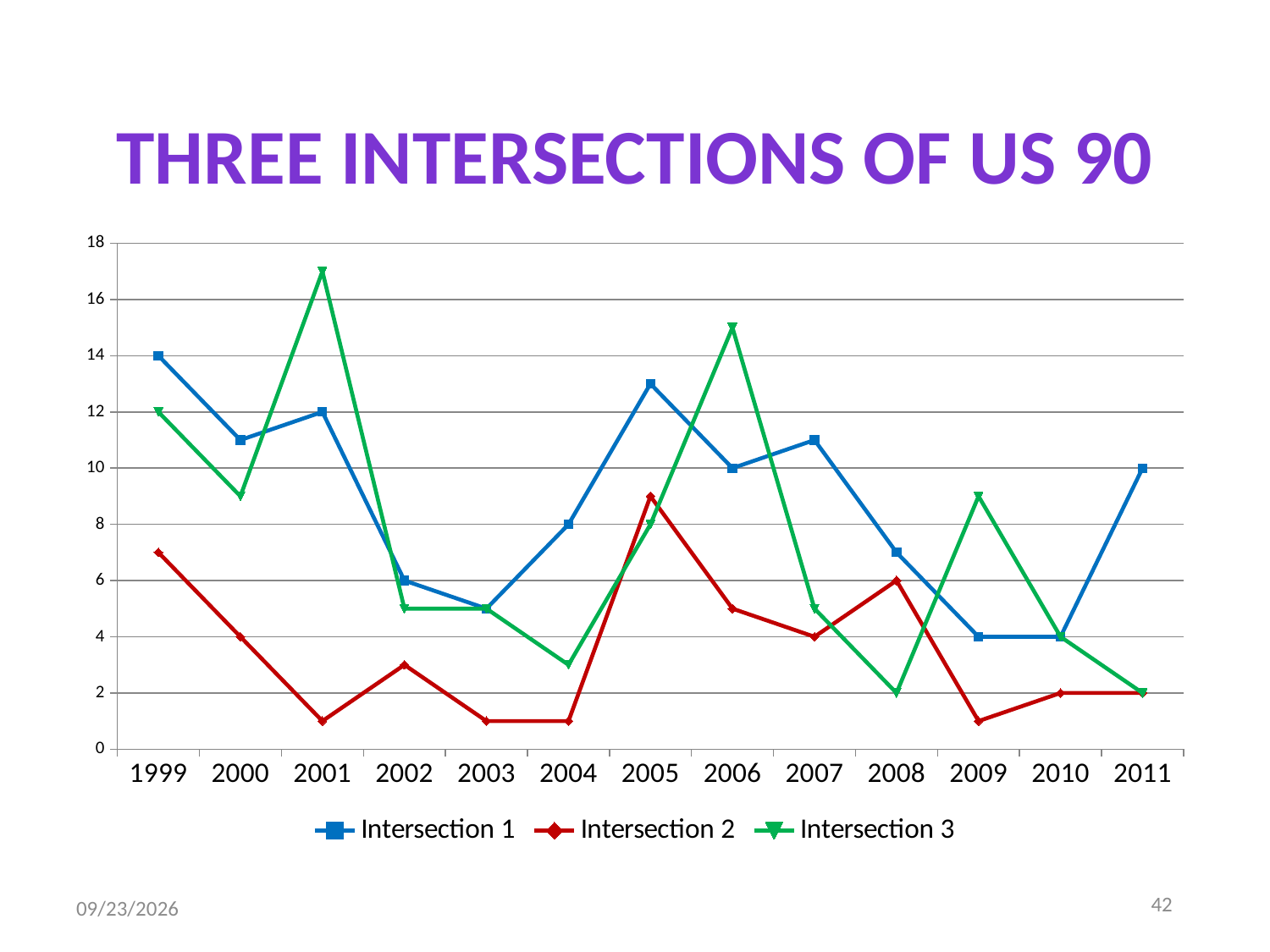
What is the title of the chart? THREE INTERSECTIONS OF US 90 How many years are shown on the x axis? 13 What is the value for Intersection 3 in 1999? 12 In which year does Intersection 3 reach its highest value? 2001 Which series has the higher value in 2006, Intersection 1 or Intersection 3? Intersection 3 What is the value for Intersection 1 in 1999? 14 What kind of chart is shown on the slide? line chart Is the value for Intersection 3 in 2001 greater or less than 16? greater What is the value for Intersection 2 in 2008? 6 Is the value for Intersection 2 in 2003 greater or less than 2? less How many series does the legend list? 3 What is the value for Intersection 1 in 2011? 10